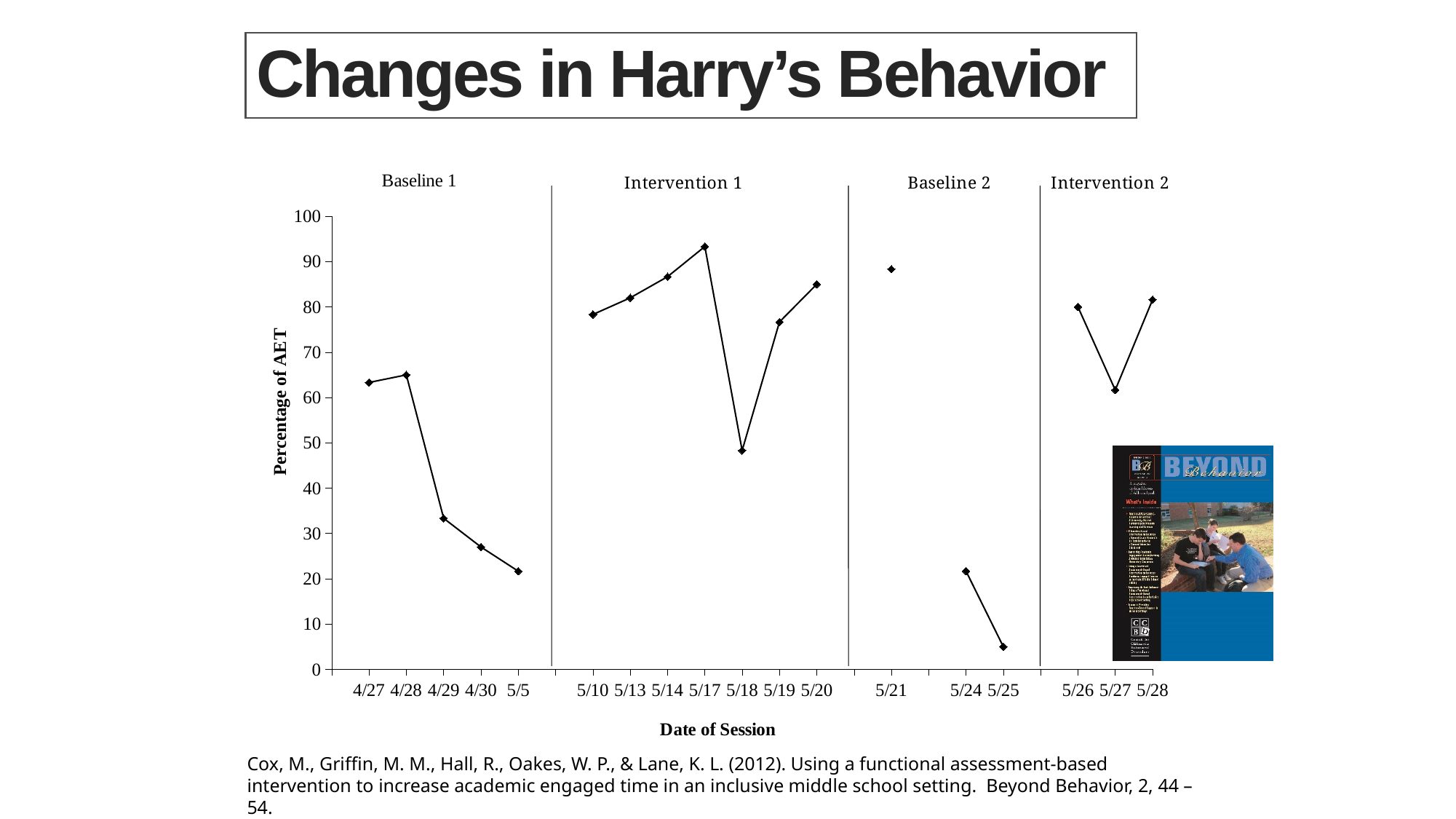
Is the percentage of AET on 5/24 greater or less than 30? less On which date of session is the percentage of AET lowest? 5/25 Is the percentage of AET on 5/21 greater or less than 80? greater Is the percentage of AET on 5/27 greater or less than 70? less Does the percentage of AET rise or fall across the Baseline 1 phase from 4/27 to 5/5? fall How many session dates are plotted along the x axis? 18 Which date has a higher percentage of AET, 5/17 or 5/18? 5/17 Which date has a higher percentage of AET, 4/28 or 4/29? 4/28 What kind of chart is shown on the slide? line chart What are the four phase labels shown above the chart? Baseline 1, Intervention 1, Baseline 2, Intervention 2 On which date of session is the percentage of AET highest? 5/17